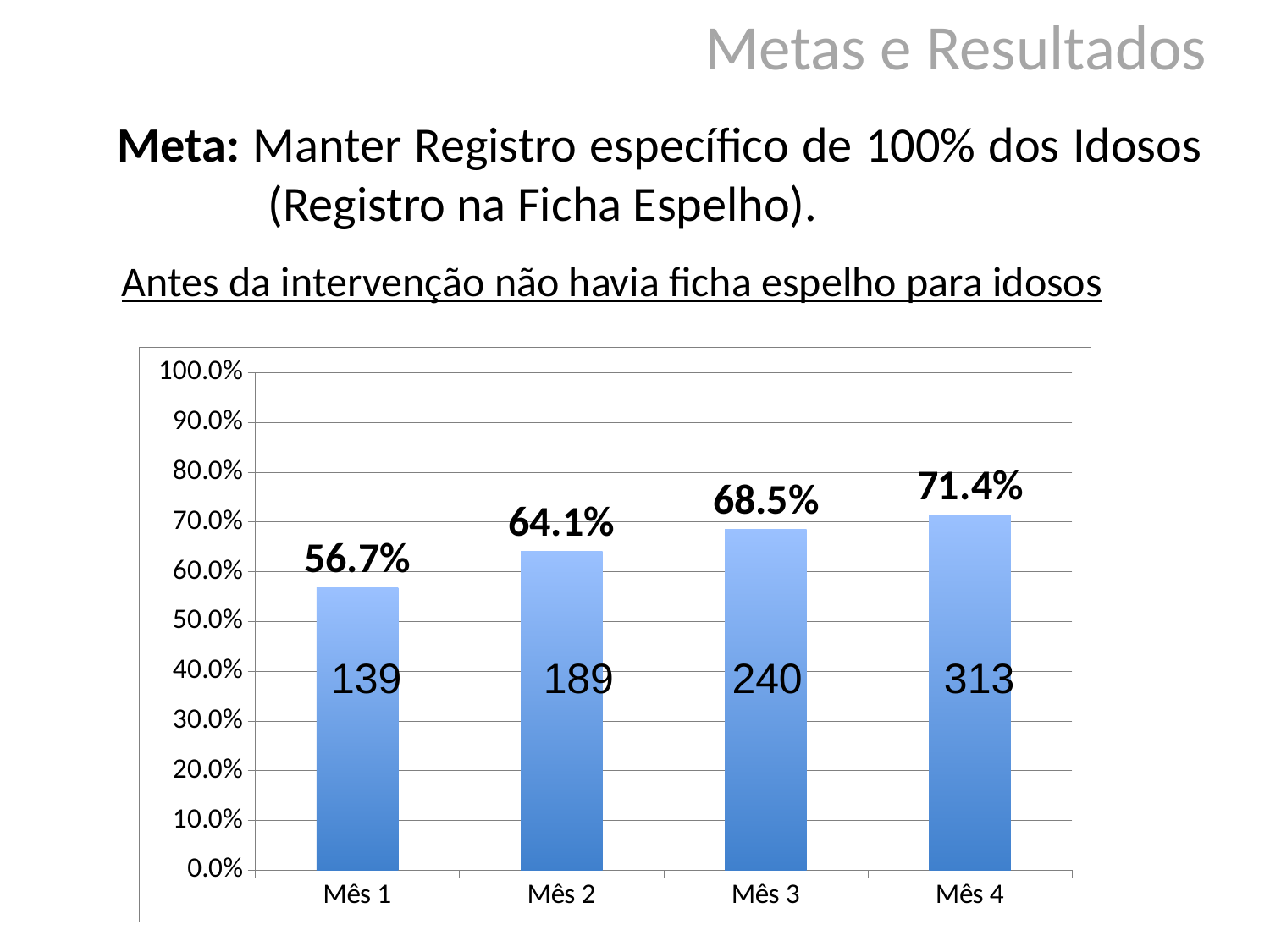
What count is printed inside the bar for Mês 4? 313 Do the percentage values rise or fall from Mês 1 to Mês 4? Rise What kind of chart is shown on the slide? Bar chart What is the percentage value shown for Mês 3? 68.5% What is the difference in percentage points between Mês 4 and Mês 1? 14.7 Which month has the lowest percentage? Mês 1 What is the percentage value shown for Mês 1? 56.7% What count is printed inside the bar for Mês 2? 189 Which month has the highest percentage? Mês 4 Which is larger, the percentage for Mês 2 or for Mês 3? Mês 3 What is the difference between the counts printed for Mês 3 and Mês 2? 51 How many months (categories) are shown on the x axis? 4